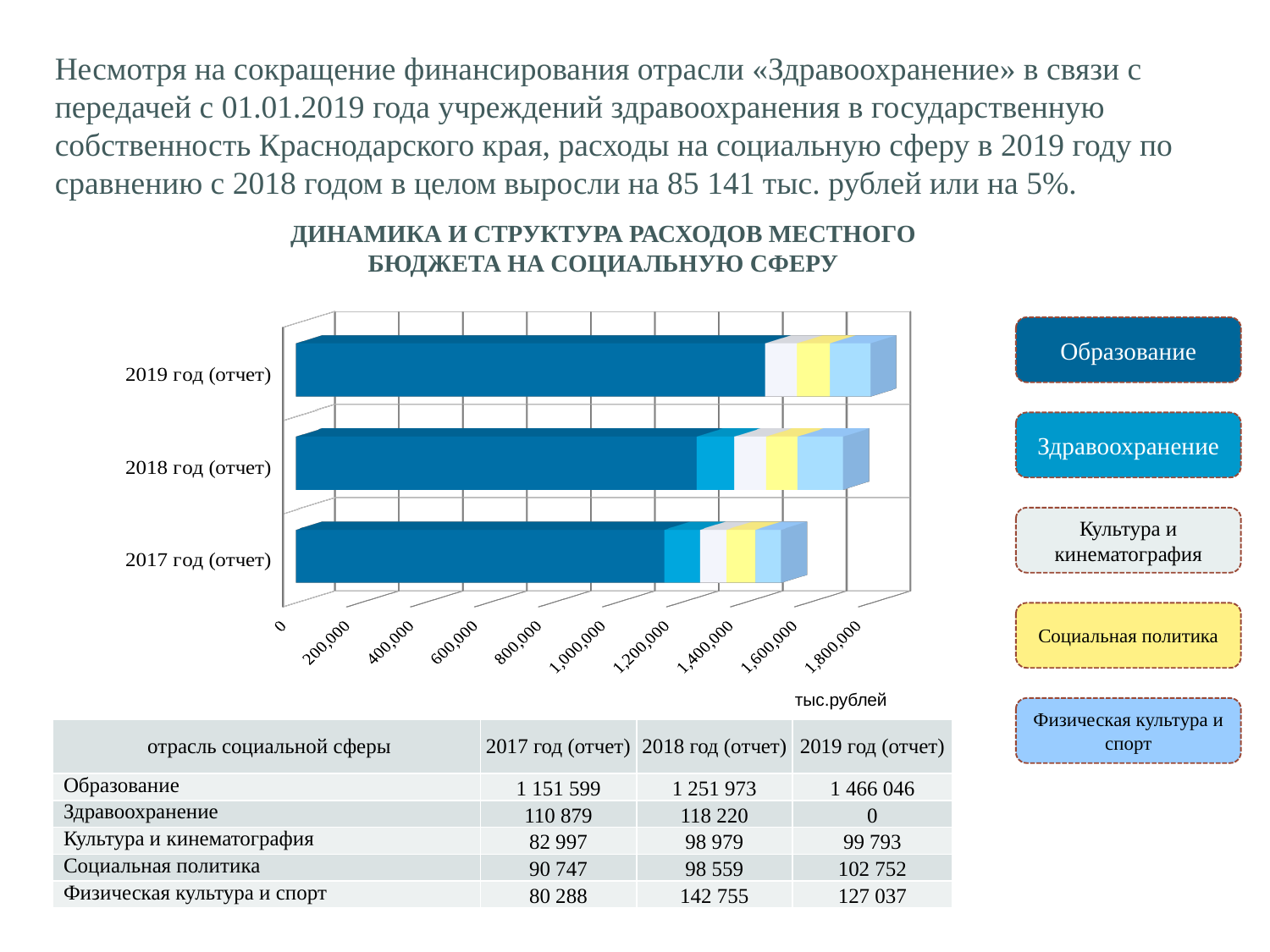
How many years (categories) are plotted on the chart? 3 Does the value for Образование rise or fall from 2017 to 2019? rise In which year is the value for Здравоохранение the lowest? 2019 год (отчет) What is the value for Образование in 2019 год (отчет)? 1 466 046 What is the total of the stacked bar for 2017 год (отчет)? 1 516 510 Which is larger in 2019 год (отчет): Социальная политика or Культура и кинематография? Социальная политика What kind of chart is shown on the slide? bar chart What is the value for Физическая культура и спорт in 2017 год (отчет)? 80 288 What is the value for Здравоохранение in 2018 год (отчет)? 118 220 How many series does the legend list? 5 By how much did Образование increase from 2018 год (отчет) to 2019 год (отчет)? 214 073 In which year is the value for Образование the highest? 2019 год (отчет)